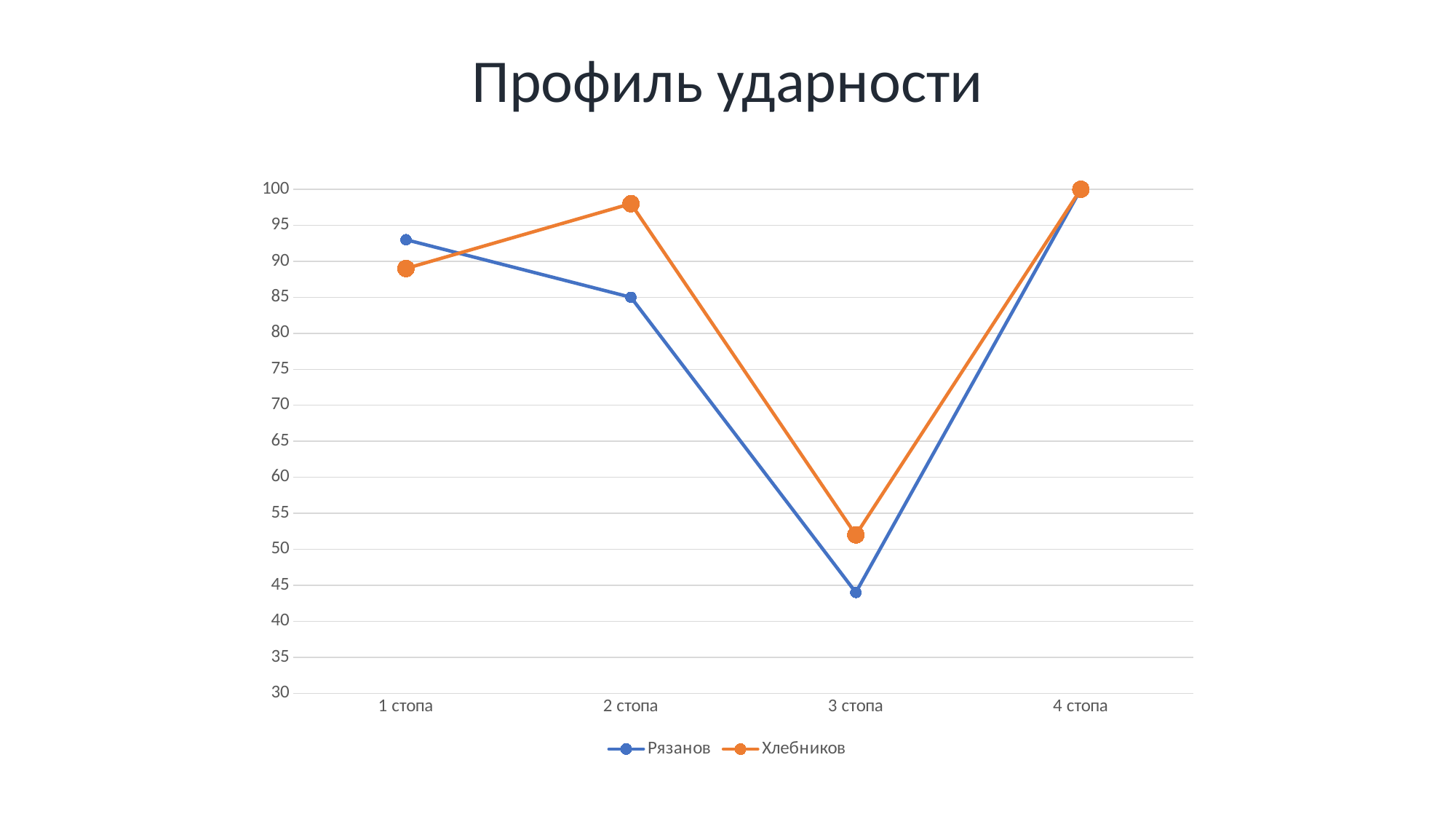
What is the value for Рязанов at 4 стопа? 100 At which category is the value for Хлебников highest? 4 стопа How many categories are shown on the x axis? 4 How many series does the legend list? 2 What is the title of the chart? Профиль ударности What kind of chart is shown on the slide? line chart Does the value for Рязанов rise or fall from 2 стопа to 3 стопа? fall Is the value for Хлебников at 2 стопа greater or less than 95? greater Is the value for Рязанов at 3 стопа greater or less than 50? less At which category is the value for Рязанов lowest? 3 стопа At 2 стопа, which series has the larger value, Рязанов or Хлебников? Хлебников What is the value for Хлебников at 4 стопа? 100